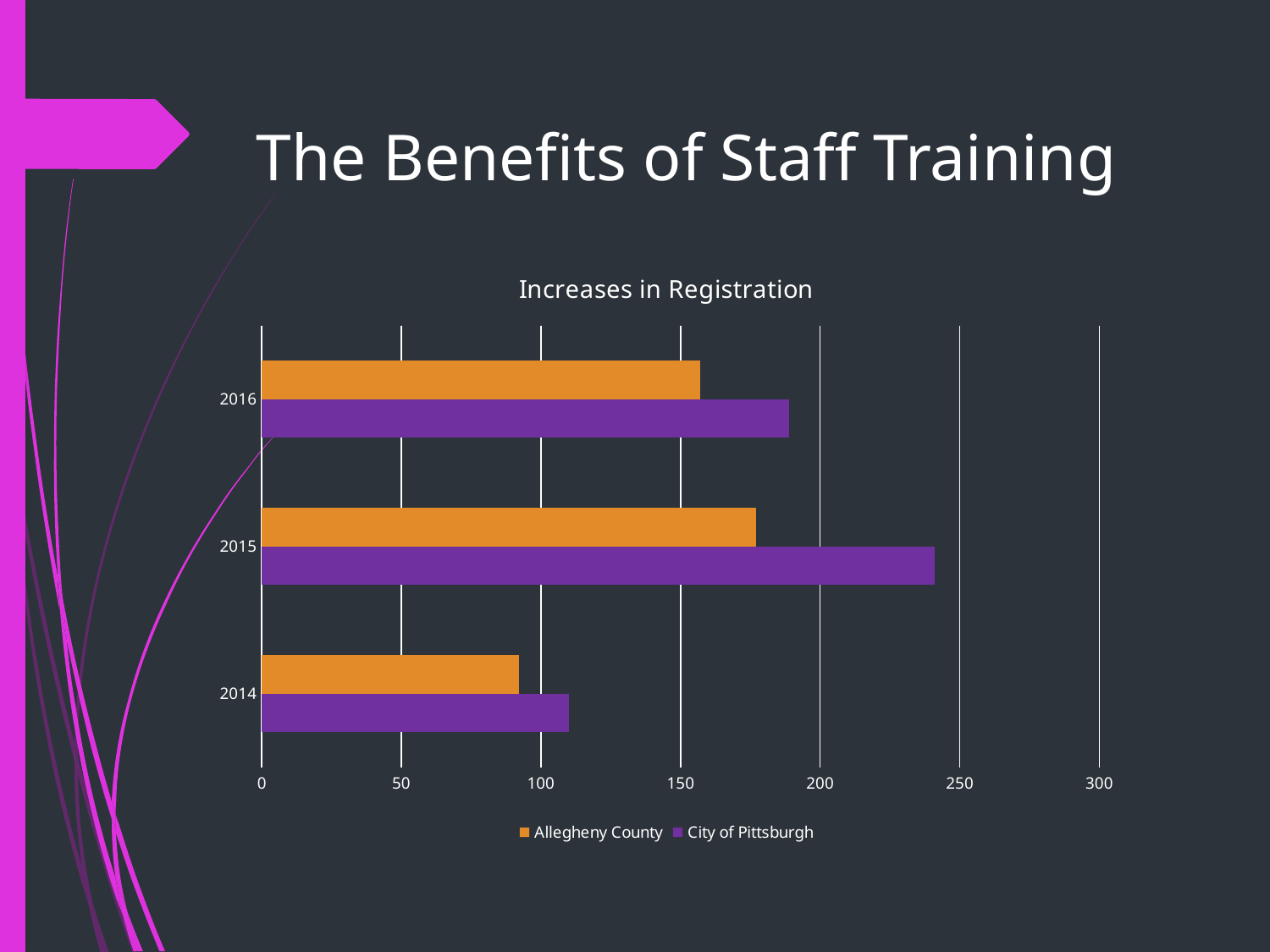
How many years are shown on the chart? 3 Is the value for Allegheny County in 2014 greater or less than 100? less Which year has the highest value for Allegheny County? 2015 What is the title of the chart? Increases in Registration Is the value for Allegheny County in 2016 greater or less than 150? greater Which year has the highest value for City of Pittsburgh? 2015 Which series is shown in orange? Allegheny County In 2015, which is larger: Allegheny County or City of Pittsburgh? City of Pittsburgh What kind of chart is shown on the slide? bar chart How many series does the legend list? 2 Is the value for City of Pittsburgh in 2015 greater or less than 200? greater Which year has the lowest value for Allegheny County? 2014